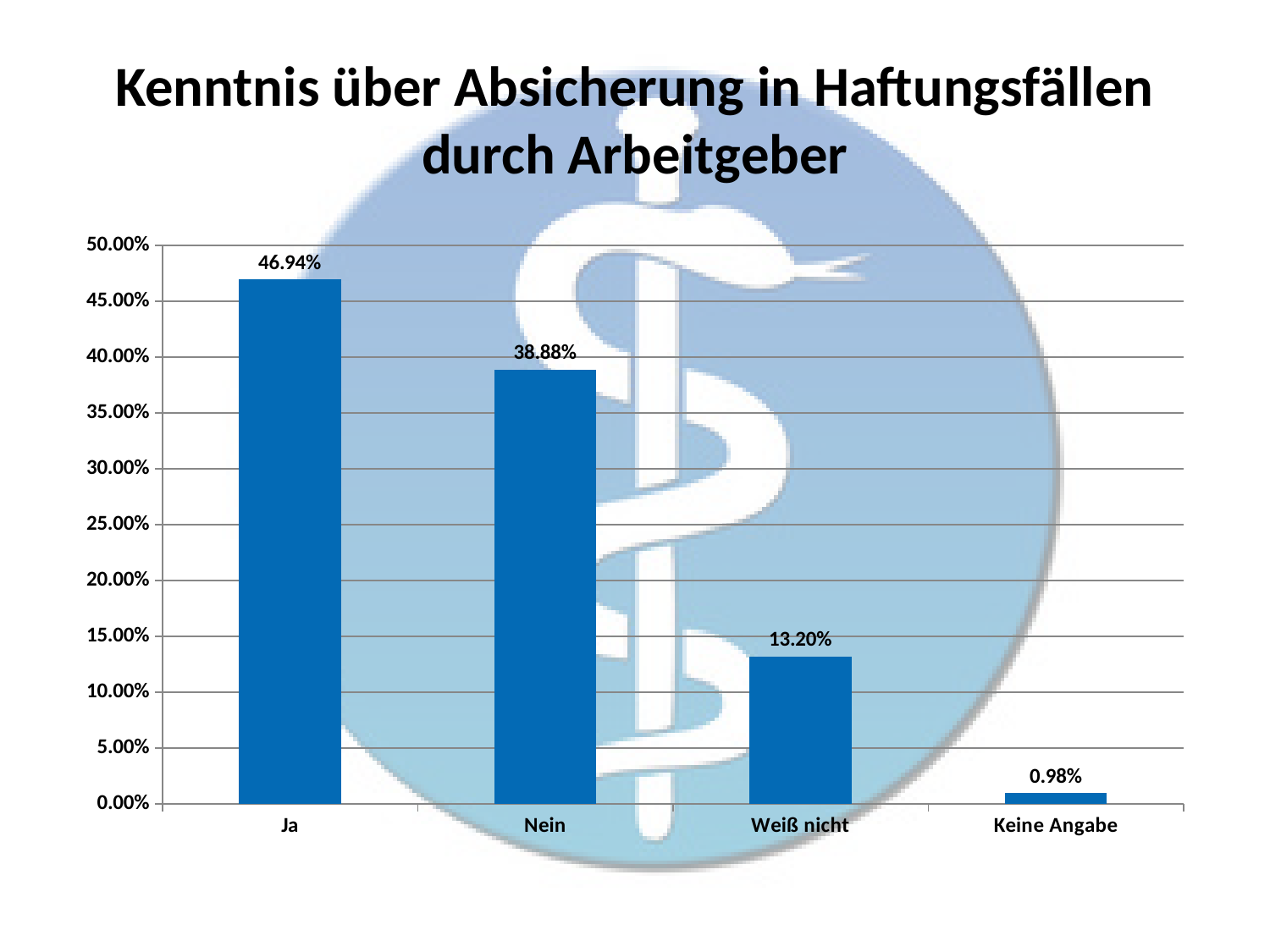
Which is larger, the value for "Nein" or the value for "Weiß nicht"? Nein What is the title of the chart? Kenntnis über Absicherung in Haftungsfällen durch Arbeitgeber What is the value for "Keine Angabe"? 0.98% What is the value for "Ja"? 46.94% How many categories are shown on the x axis? 4 Which category has the lowest value? Keine Angabe What kind of chart is shown on the slide? bar chart What is the difference between the values for "Ja" and "Nein"? 8.06% What is the value for "Weiß nicht"? 13.20% What is the value for "Nein"? 38.88% Is the value for "Weiß nicht" greater or less than 15.00%? less Which category has the highest value? Ja